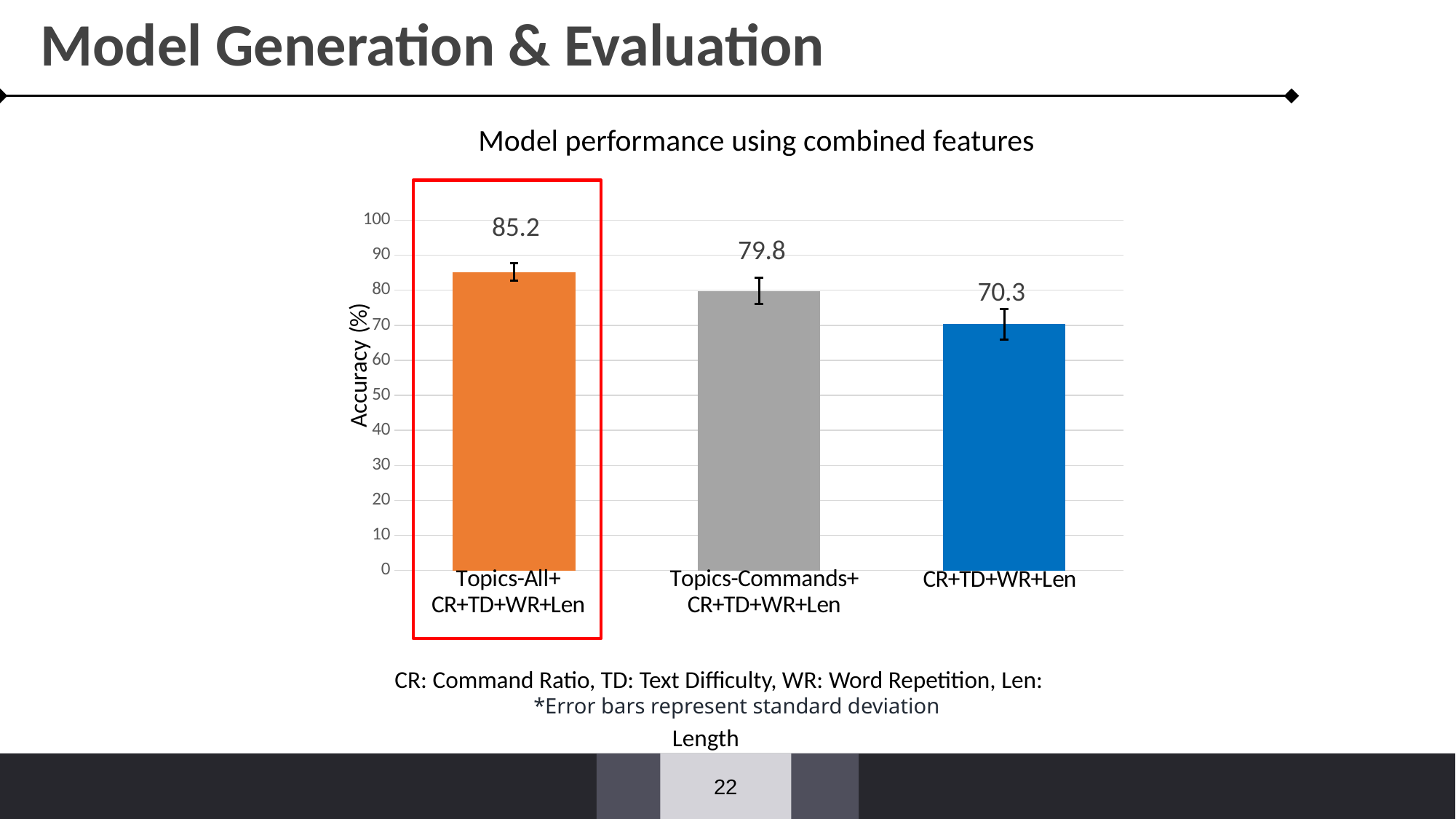
Is the accuracy for CR+TD+WR+Len greater or less than 80? less What is the accuracy for Topics-All+CR+TD+WR+Len? 85.2 What is the accuracy for Topics-Commands+CR+TD+WR+Len? 79.8 What is the difference in accuracy between Topics-All+CR+TD+WR+Len and CR+TD+WR+Len? 14.9 What is the accuracy for CR+TD+WR+Len? 70.3 Which feature combination has the highest accuracy? Topics-All+CR+TD+WR+Len What kind of chart is shown on the slide? bar chart Which has a higher accuracy, Topics-Commands+CR+TD+WR+Len or CR+TD+WR+Len? Topics-Commands+CR+TD+WR+Len What is the difference in accuracy between Topics-All+CR+TD+WR+Len and Topics-Commands+CR+TD+WR+Len? 5.4 Which feature combination has the lowest accuracy? CR+TD+WR+Len What is the title of the chart? Model performance using combined features How many feature combinations are shown in the chart? 3